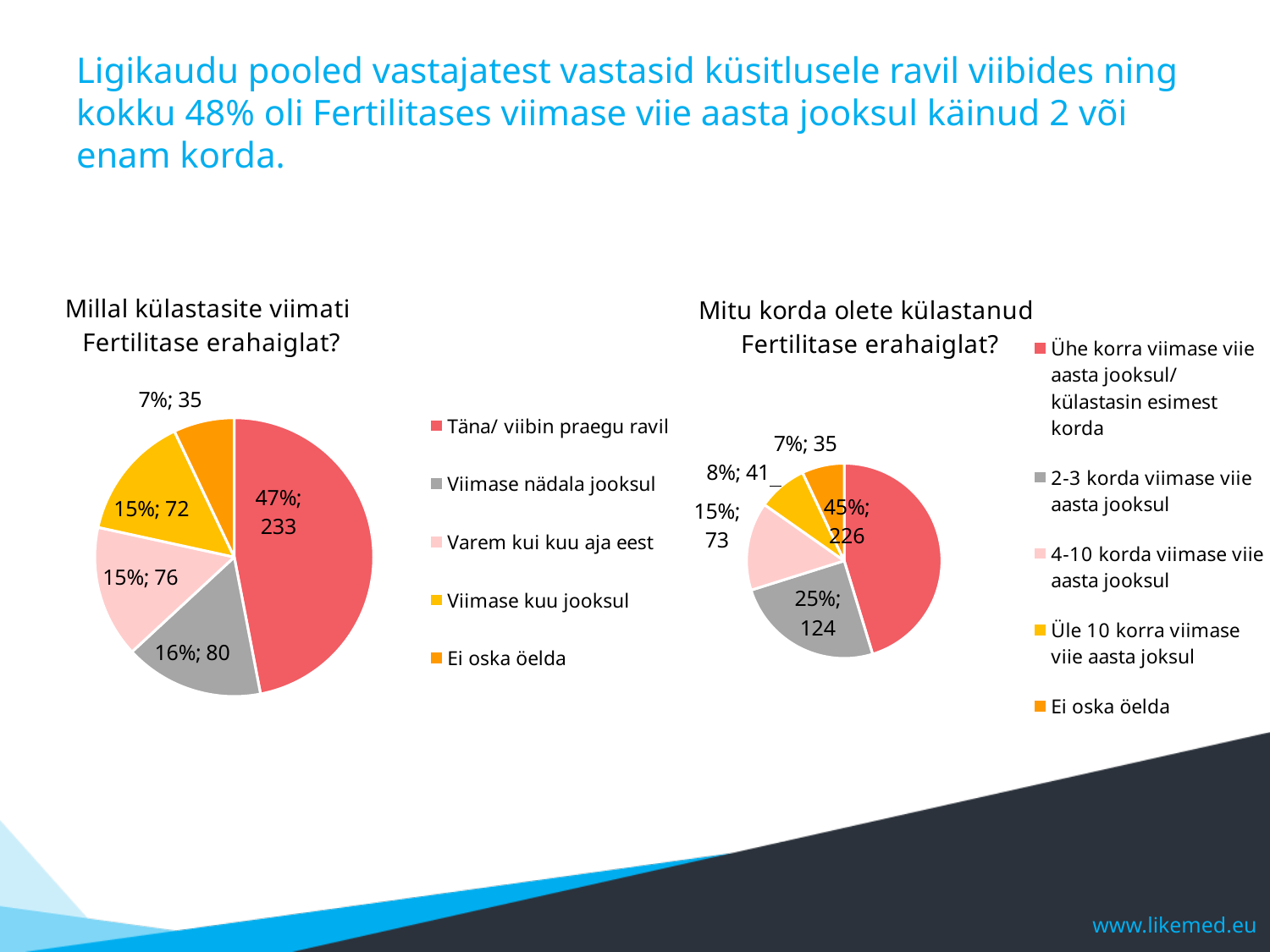
In the chart titled "Millal külastasite viimati Fertilitase erahaiglat?", which category has the largest slice? Täna/ viibin praegu ravil In the chart titled "Millal külastasite viimati Fertilitase erahaiglat?", what is the difference in count between "Viimase nädala jooksul" and "Varem kui kuu aja eest"? 4 In the chart titled "Mitu korda olete külastanud Fertilitase erahaiglat?", which is larger: the count for "4-10 korda viimase viie aasta jooksul" or for "Üle 10 korra viimase viie aasta joksul"? 4-10 korda viimase viie aasta jooksul In the chart titled "Mitu korda olete külastanud Fertilitase erahaiglat?", which category has the largest share? Ühe korra viimase viie aasta jooksul/ külastasin esimest korda In the chart titled "Millal külastasite viimati Fertilitase erahaiglat?", what percentage is shown for "Viimase nädala jooksul"? 16% In the chart titled "Mitu korda olete külastanud Fertilitase erahaiglat?", what is the difference in count between "Ühe korra viimase viie aasta jooksul/ külastasin esimest korda" and "2-3 korda viimase viie aasta jooksul"? 102 In the chart titled "Millal külastasite viimati Fertilitase erahaiglat?", which category has the smallest slice? Ei oska öelda In the chart titled "Millal külastasite viimati Fertilitase erahaiglat?", how many categories does the legend list? 5 What type of chart is the chart titled "Mitu korda olete külastanud Fertilitase erahaiglat?"? Pie chart In the chart titled "Mitu korda olete külastanud Fertilitase erahaiglat?", what count is shown for "2-3 korda viimase viie aasta jooksul"? 124 In the chart titled "Mitu korda olete külastanud Fertilitase erahaiglat?", what percentage is shown for "Üle 10 korra viimase viie aasta joksul"? 8% In the chart titled "Millal külastasite viimati Fertilitase erahaiglat?", what count is shown for "Täna/ viibin praegu ravil"? 233